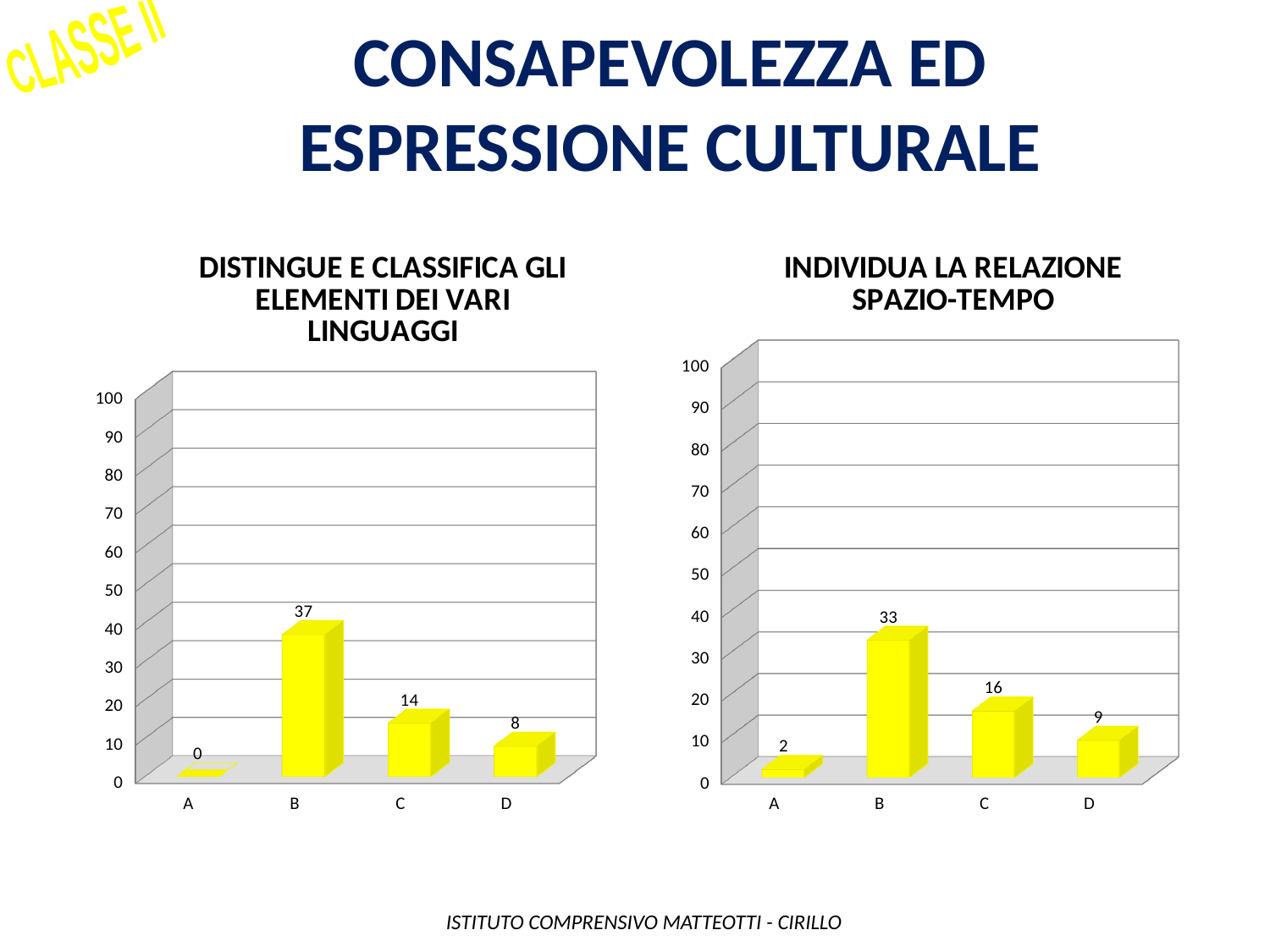
In the right chart (INDIVIDUA LA RELAZIONE SPAZIO-TEMPO), what is the value for category C? 16 In the right chart (INDIVIDUA LA RELAZIONE SPAZIO-TEMPO), is the value for B greater or less than 30? greater What is the title of the left chart? DISTINGUE E CLASSIFICA GLI ELEMENTI DEI VARI LINGUAGGI In the left chart (DISTINGUE E CLASSIFICA GLI ELEMENTI DEI VARI LINGUAGGI), which is larger, the value for C or the value for D? C In the left chart (DISTINGUE E CLASSIFICA GLI ELEMENTI DEI VARI LINGUAGGI), what is the value for category A? 0 How many categories are shown on the x axis of the left chart (DISTINGUE E CLASSIFICA GLI ELEMENTI DEI VARI LINGUAGGI)? 4 In the right chart (INDIVIDUA LA RELAZIONE SPAZIO-TEMPO), which category has the highest value? B In the left chart (DISTINGUE E CLASSIFICA GLI ELEMENTI DEI VARI LINGUAGGI), which category has the lowest value? A What kind of chart is the right chart (INDIVIDUA LA RELAZIONE SPAZIO-TEMPO)? Bar chart In the left chart (DISTINGUE E CLASSIFICA GLI ELEMENTI DEI VARI LINGUAGGI), what is the value for category B? 37 In the right chart (INDIVIDUA LA RELAZIONE SPAZIO-TEMPO), what is the difference between the values for B and D? 24 In the right chart (INDIVIDUA LA RELAZIONE SPAZIO-TEMPO), what is the value for category A? 2